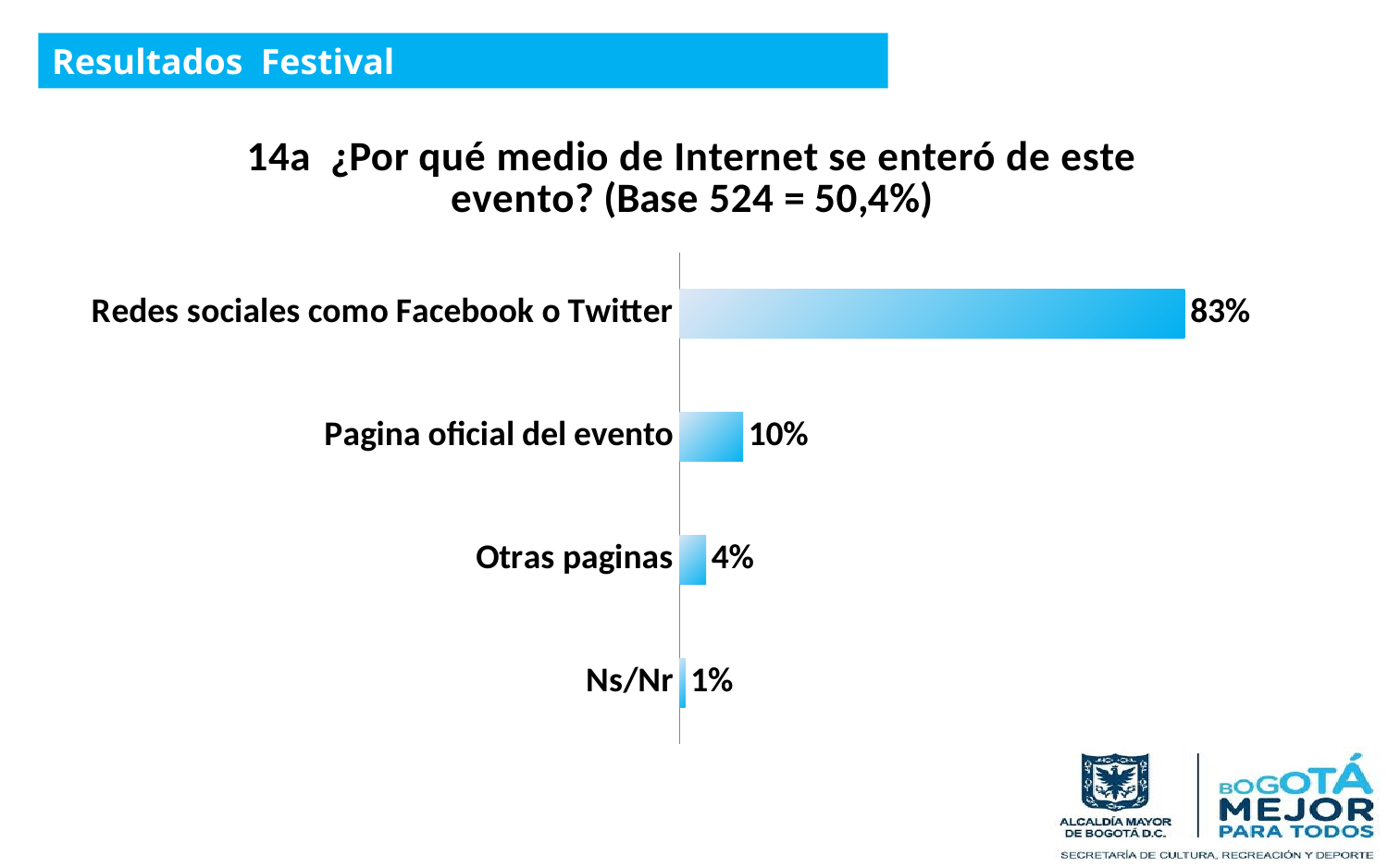
Which is larger, the value for "Otras paginas" or the value for "Ns/Nr"? Otras paginas What kind of chart is shown on the slide? Bar chart How many categories are shown in the chart? 4 What is the title of the chart? 14a ¿Por qué medio de Internet se enteró de este evento? (Base 524 = 50,4%) What is the difference between the values for "Redes sociales como Facebook o Twitter" and "Pagina oficial del evento"? 73% Which category has the highest value? Redes sociales como Facebook o Twitter What is the difference between the values for "Pagina oficial del evento" and "Otras paginas"? 6% What is the value for "Pagina oficial del evento"? 10% What is the value for "Ns/Nr"? 1% What is the value for "Redes sociales como Facebook o Twitter"? 83% What is the value for "Otras paginas"? 4% Which category has the lowest value? Ns/Nr